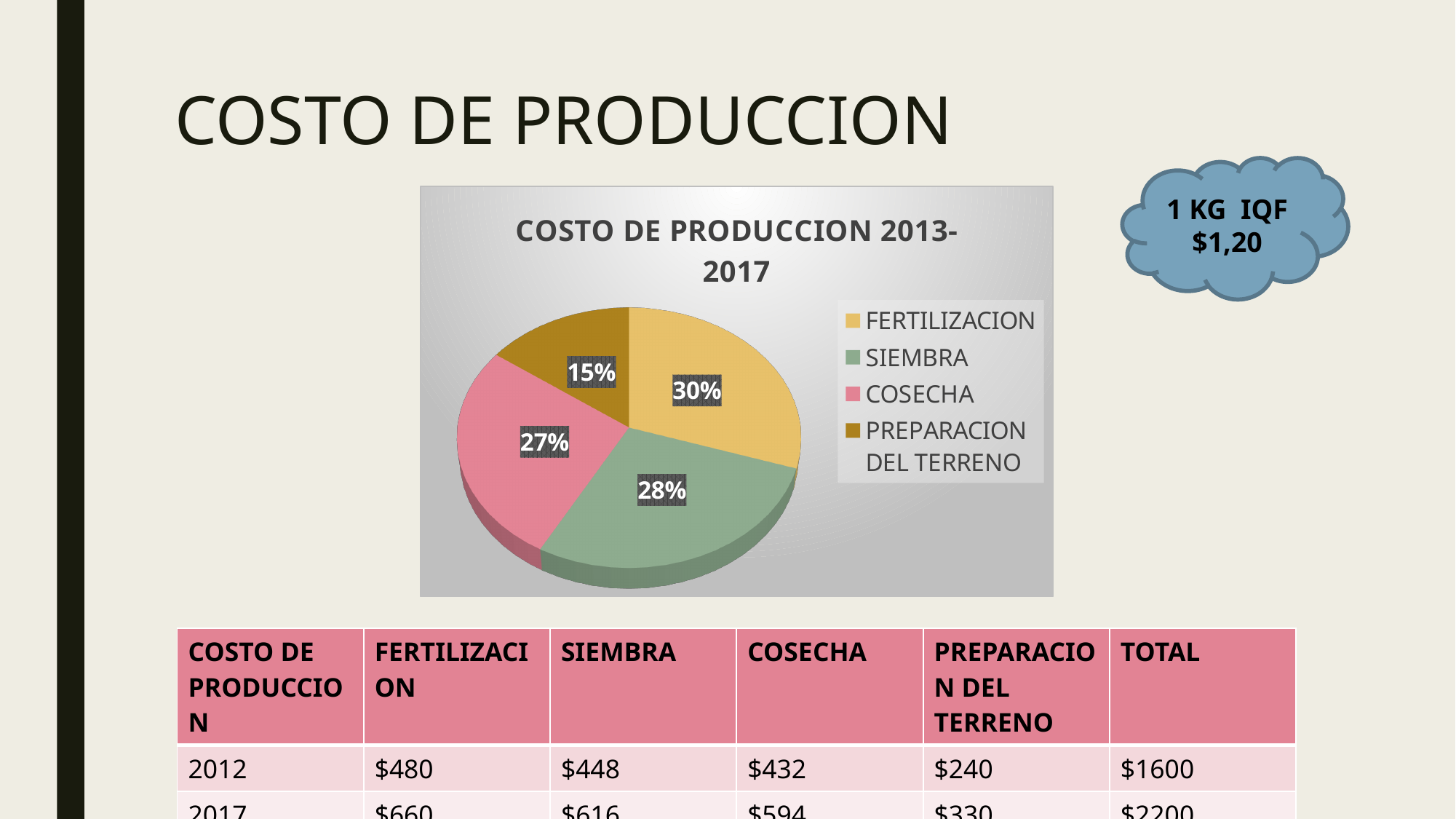
What kind of chart is shown on the slide? pie chart What share of the pie does SIEMBRA represent? 28% What is the difference in percentage points between the FERTILIZACION slice and the PREPARACION DEL TERRENO slice? 15% What colour is the COSECHA slice in the pie chart? pink How many slices does the pie chart have? 4 What share of the pie does FERTILIZACION represent? 30% Which category has the largest slice of the pie? FERTILIZACION Which category has the smallest slice of the pie? PREPARACION DEL TERRENO What share of the pie does COSECHA represent? 27% Which slice is larger, SIEMBRA or PREPARACION DEL TERRENO? SIEMBRA What is the title of the chart? COSTO DE PRODUCCION 2013-2017